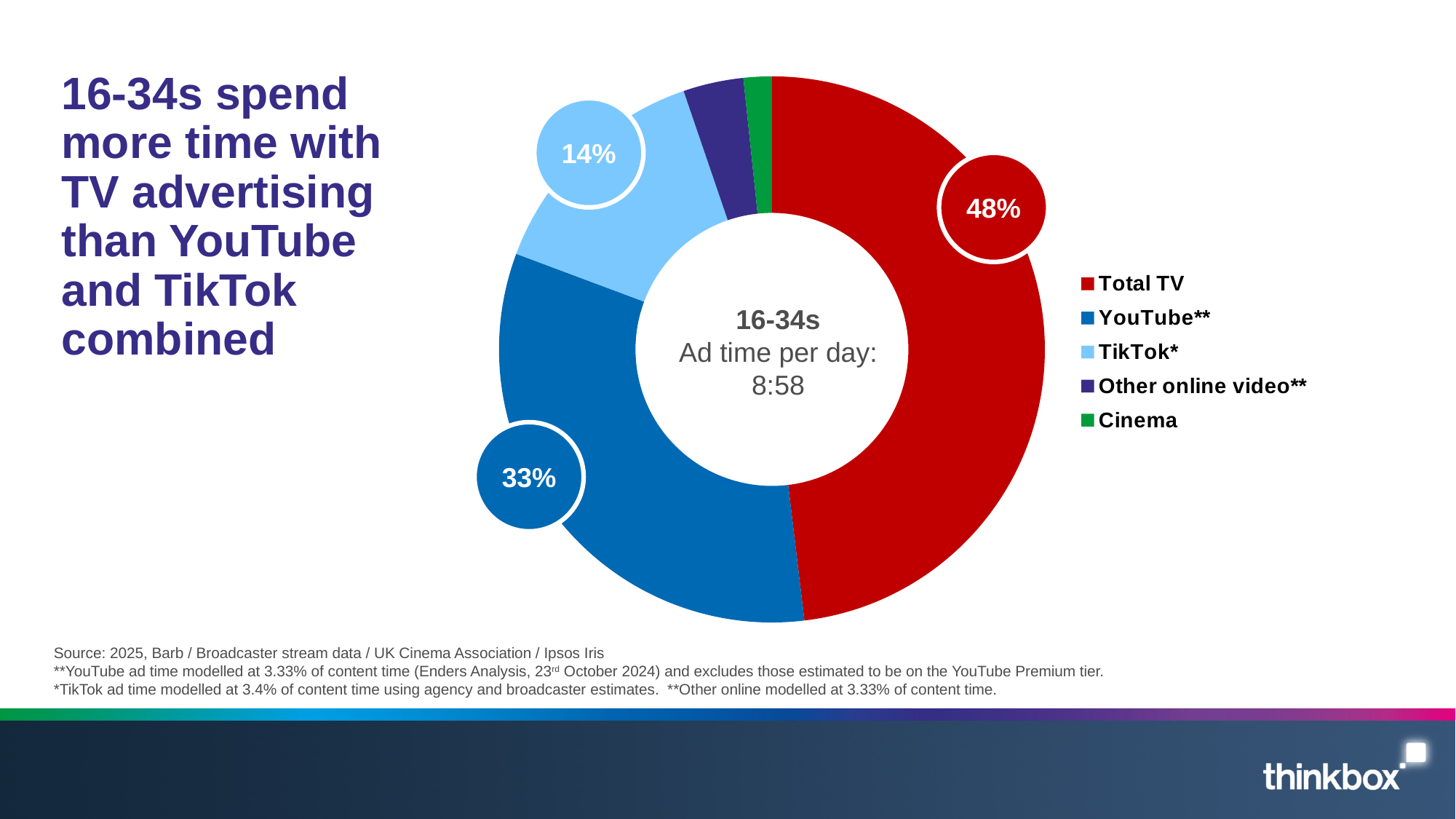
Which is larger, the share for YouTube** or the share for TikTok*? YouTube** What kind of chart is shown on the slide? Donut (pie) chart How many categories does the legend list? 5 What share of 16-34s' ad time per day goes to Total TV? 48% What share of 16-34s' ad time per day goes to YouTube**? 33% Which category has the smallest share of the donut chart? Cinema Which colour represents Cinema in the chart? Green What is the combined share of YouTube** and TikTok*? 47% Which category has the largest share of the donut chart? Total TV What share of 16-34s' ad time per day goes to TikTok*? 14% What is the difference in percentage points between the Total TV share and the YouTube** share? 15 What ad time per day is shown in the centre of the donut chart for 16-34s? 8:58